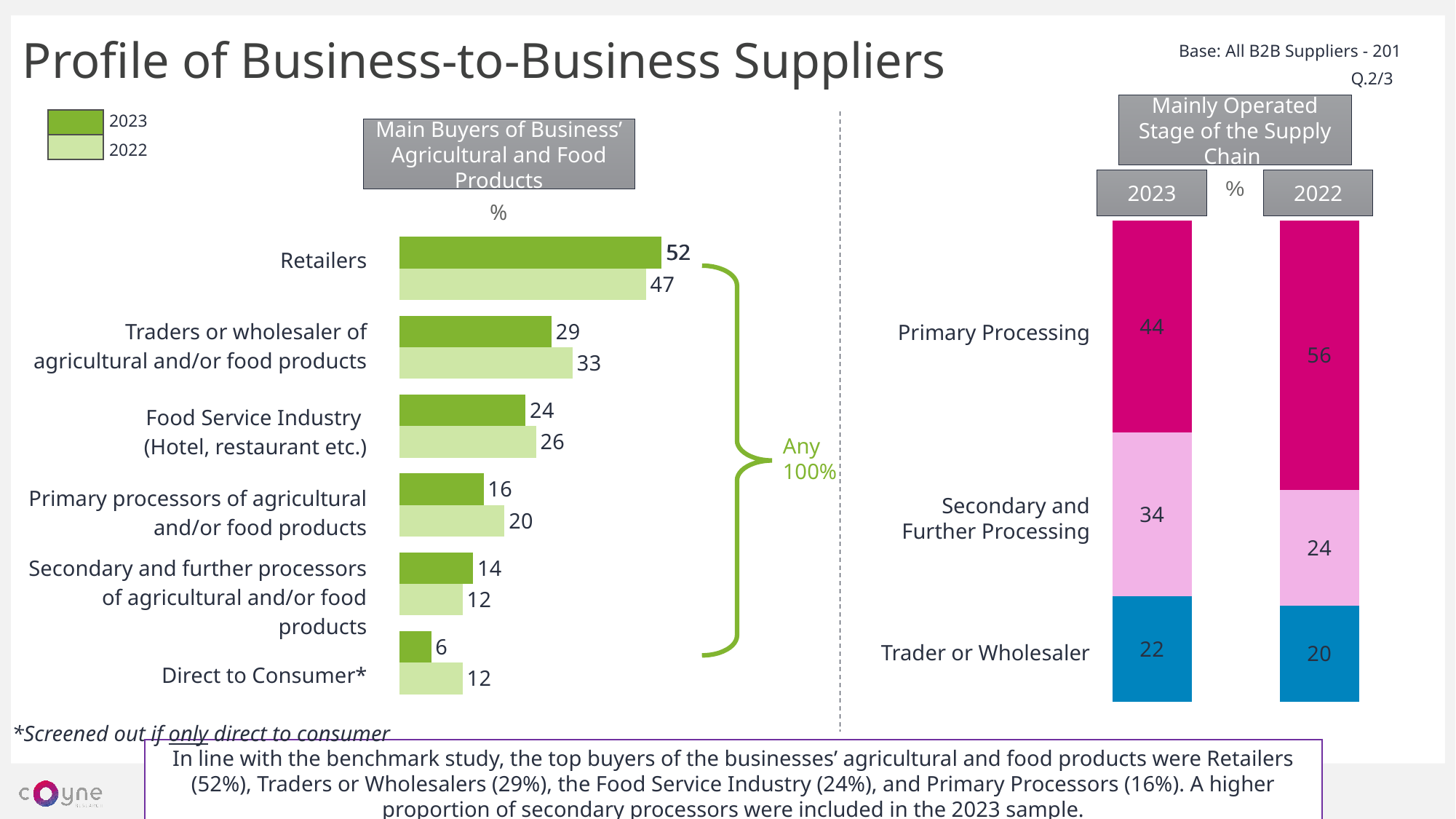
In the 'Main Buyers of Business' Agricultural and Food Products' chart, which category has the highest 2022 value? Retailers In the 'Main Buyers of Business' Agricultural and Food Products' chart, what is the 2022 value for Traders or wholesaler of agricultural and/or food products? 33 In the 'Main Buyers of Business' Agricultural and Food Products' chart, what is the 2023 value for Retailers? 52 How many buyer categories are shown in the 'Main Buyers of Business' Agricultural and Food Products' chart? 6 In the 'Main Buyers of Business' Agricultural and Food Products' chart, is the 2023 value for Food Service Industry (Hotel, restaurant etc.) larger or smaller than its 2022 value? smaller In the 'Mainly Operated Stage of the Supply Chain' chart, what is the 2022 value for Primary Processing? 56 In the 'Mainly Operated Stage of the Supply Chain' chart, what is the total of the 2023 stacked bar? 100 How many series does the legend list for the 'Main Buyers of Business' Agricultural and Food Products' chart? 2 In the 'Main Buyers of Business' Agricultural and Food Products' chart, which category has the lowest 2023 value? Direct to Consumer* In the 'Mainly Operated Stage of the Supply Chain' chart, what is the difference between the 2023 and 2022 values for Secondary and Further Processing? 10 In the 'Main Buyers of Business' Agricultural and Food Products' chart, what is the difference between the 2023 and 2022 values for Retailers? 5 What kind of chart is the 'Mainly Operated Stage of the Supply Chain' chart? stacked bar chart